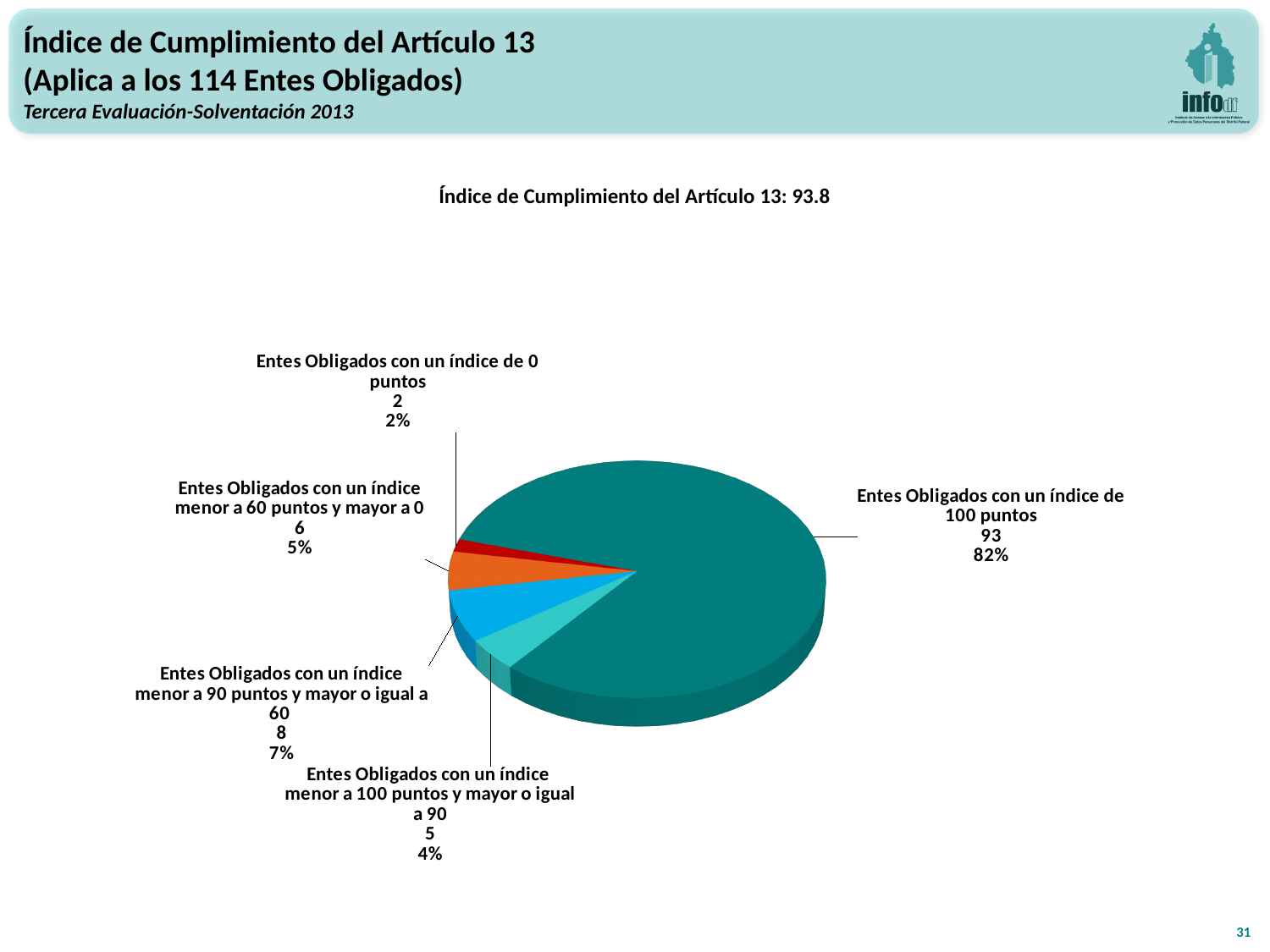
How many Entes Obligados have an índice de 0 puntos? 2 What share of the pie corresponds to Entes Obligados con un índice de 100 puntos? 82% What percentage of the pie is the slice for Entes Obligados con un índice menor a 90 puntos y mayor o igual a 60? 7% What kind of chart is shown on the slide? pie chart What is the Índice de Cumplimiento del Artículo 13 value stated above the chart? 93.8 Which is larger: the number of Entes Obligados with an índice menor a 90 puntos y mayor o igual a 60, or those with an índice menor a 60 puntos y mayor a 0? Entes Obligados con un índice menor a 90 puntos y mayor o igual a 60 Which category has the largest slice of the pie? Entes Obligados con un índice de 100 puntos How many slices does the pie chart have? 5 Which category has the smallest slice of the pie? Entes Obligados con un índice de 0 puntos What is the difference between the number of Entes Obligados with an índice de 100 puntos and those with an índice menor a 60 puntos y mayor a 0? 87 How many Entes Obligados have an índice menor a 100 puntos y mayor o igual a 90? 5 How many Entes Obligados have an índice de 100 puntos? 93